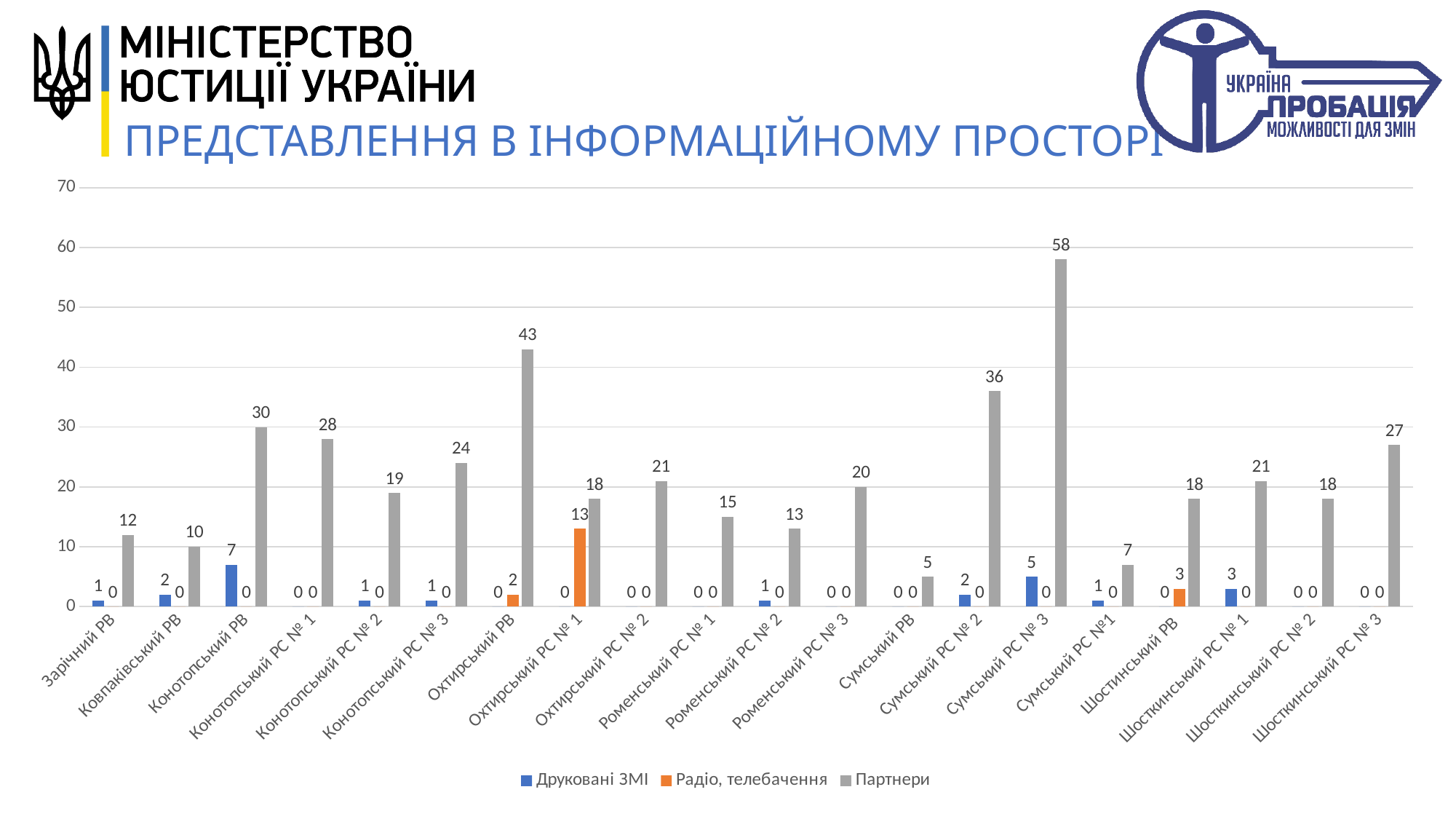
What kind of chart is shown on the slide? Bar chart Which is larger: the Партнери value for Конотопський РВ or for Конотопський РС № 1? Конотопський РВ What is the value of Партнери for Сумський РС № 3? 58 Which category has the lowest Партнери value? Сумський РВ Which category has the highest Партнери value? Сумський РС № 3 What is the value of Друковані ЗМІ for Конотопський РВ? 7 How many series does the legend list? 3 What is the value of Радіо, телебачення for Охтирський РС № 1? 13 What is the total of the three series for Охтирський РС № 1? 31 What is the difference between the Партнери values for Охтирський РВ and Сумський РС № 2? 7 How many categories are shown on the x axis? 20 Which series is shown in orange in the legend? Радіо, телебачення